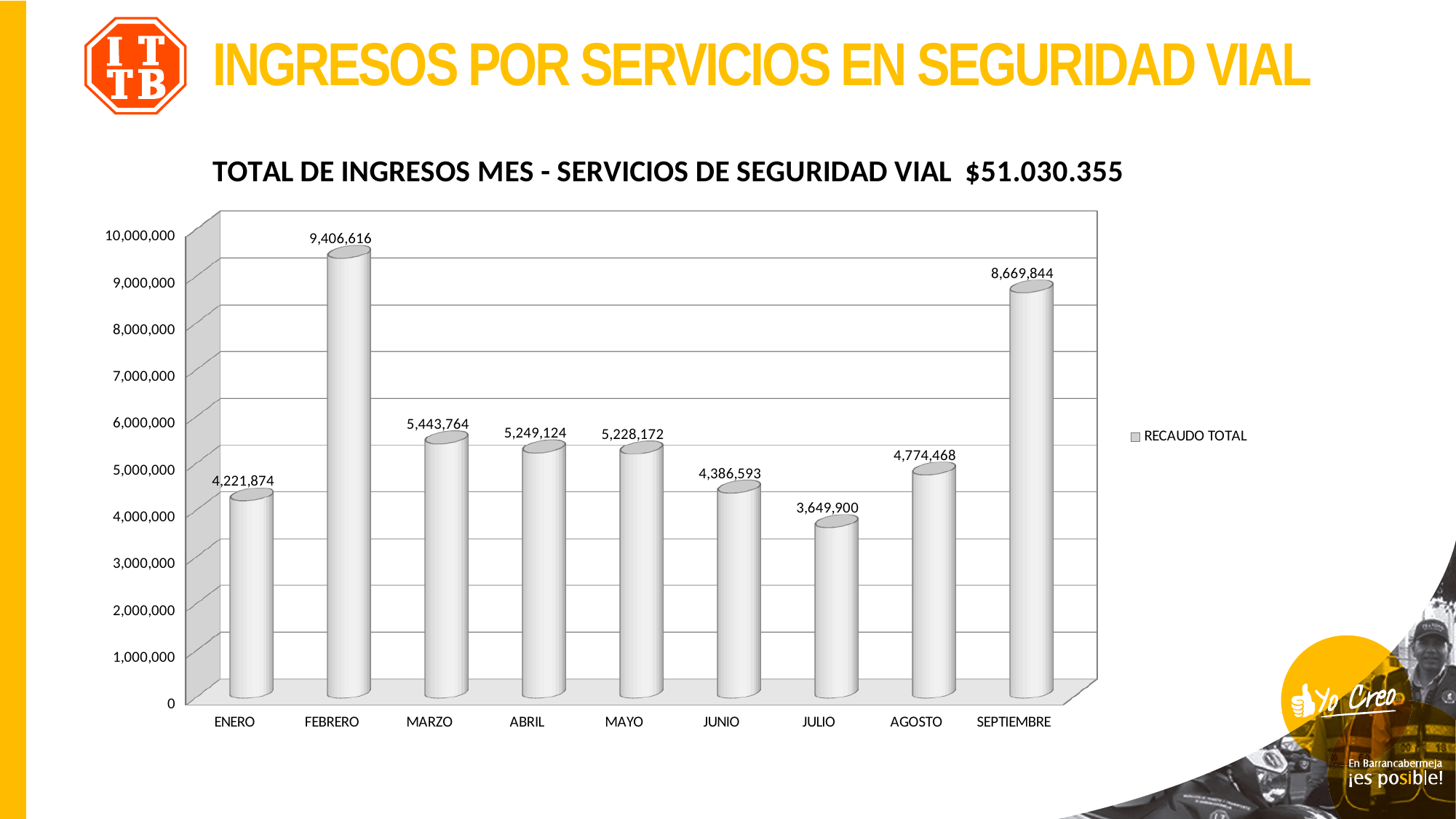
What kind of chart is shown on the slide? bar chart What is the difference between the values for FEBRERO and SEPTIEMBRE? 736,772 Which month has the lowest value? JULIO Which month has the highest value? FEBRERO How many months are shown on the x axis? 9 Is the value for JULIO greater or less than 4,000,000? less Which is larger, the value for AGOSTO or the value for JUNIO? AGOSTO What is the difference between the values for ENERO and JULIO? 571,974 How many series does the legend list? 1 What is the value for JULIO? 3,649,900 What is the value for SEPTIEMBRE? 8,669,844 What is the value for FEBRERO? 9,406,616